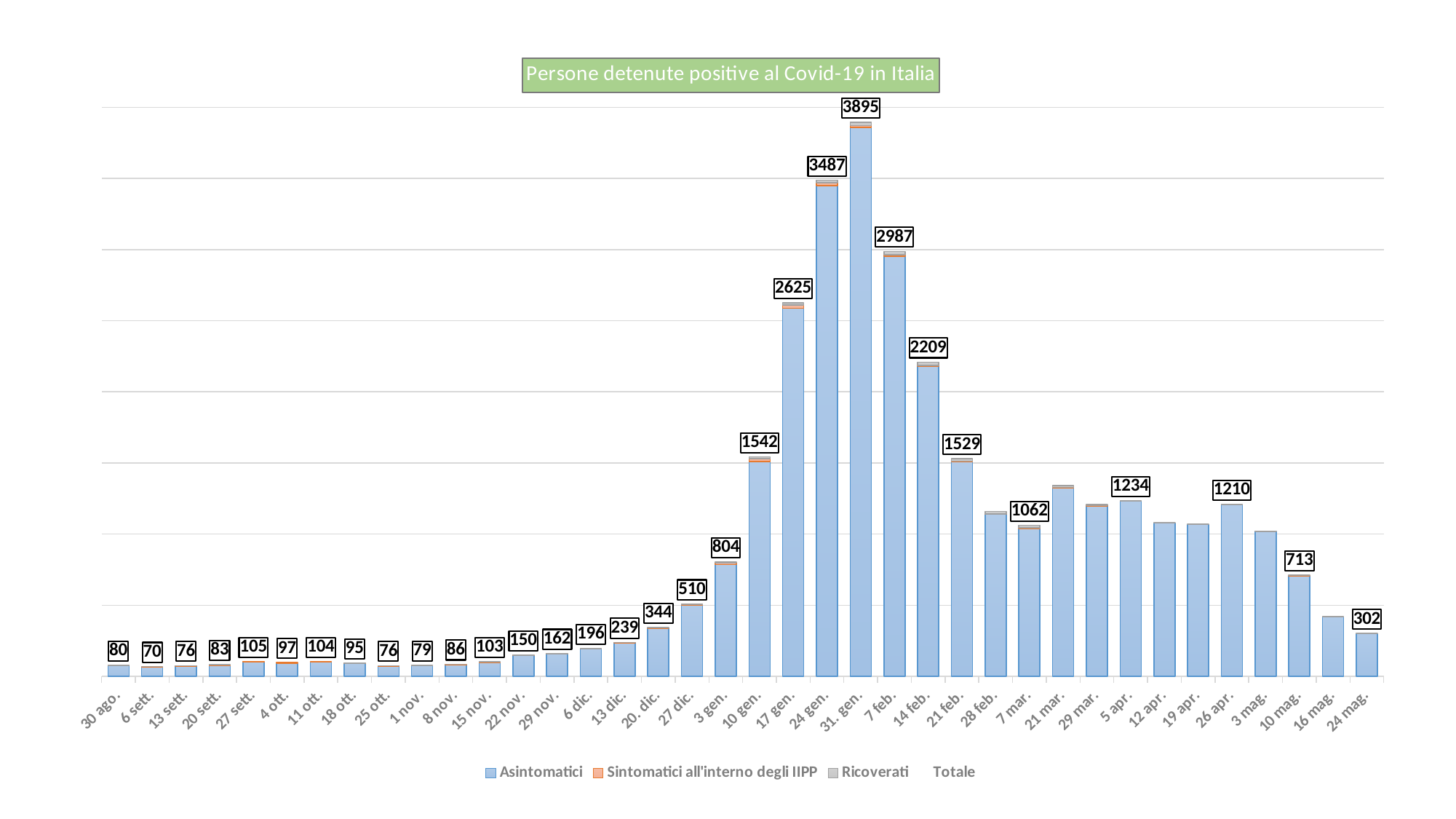
What is the total value labelled for 10 gen.? 1542 Which date has the lowest total of positive detainees? 6 sett. Do the totals rise or fall from 31. gen. to 24 mag.? Fall What is the total value labelled for 24 mag.? 302 How many dates are shown on the x axis? 38 What is the difference between the totals for 10 gen. and 3 gen.? 738 Which date has the highest total of positive detainees? 31. gen. How many entries does the legend list? 4 What is the total number of positive detainees shown for 31. gen.? 3895 Which is larger, the total for 24 gen. or the total for 17 gen.? 24 gen. What kind of chart is shown on the slide? Stacked bar chart What is the difference between the totals for 31. gen. and 7 feb.? 908